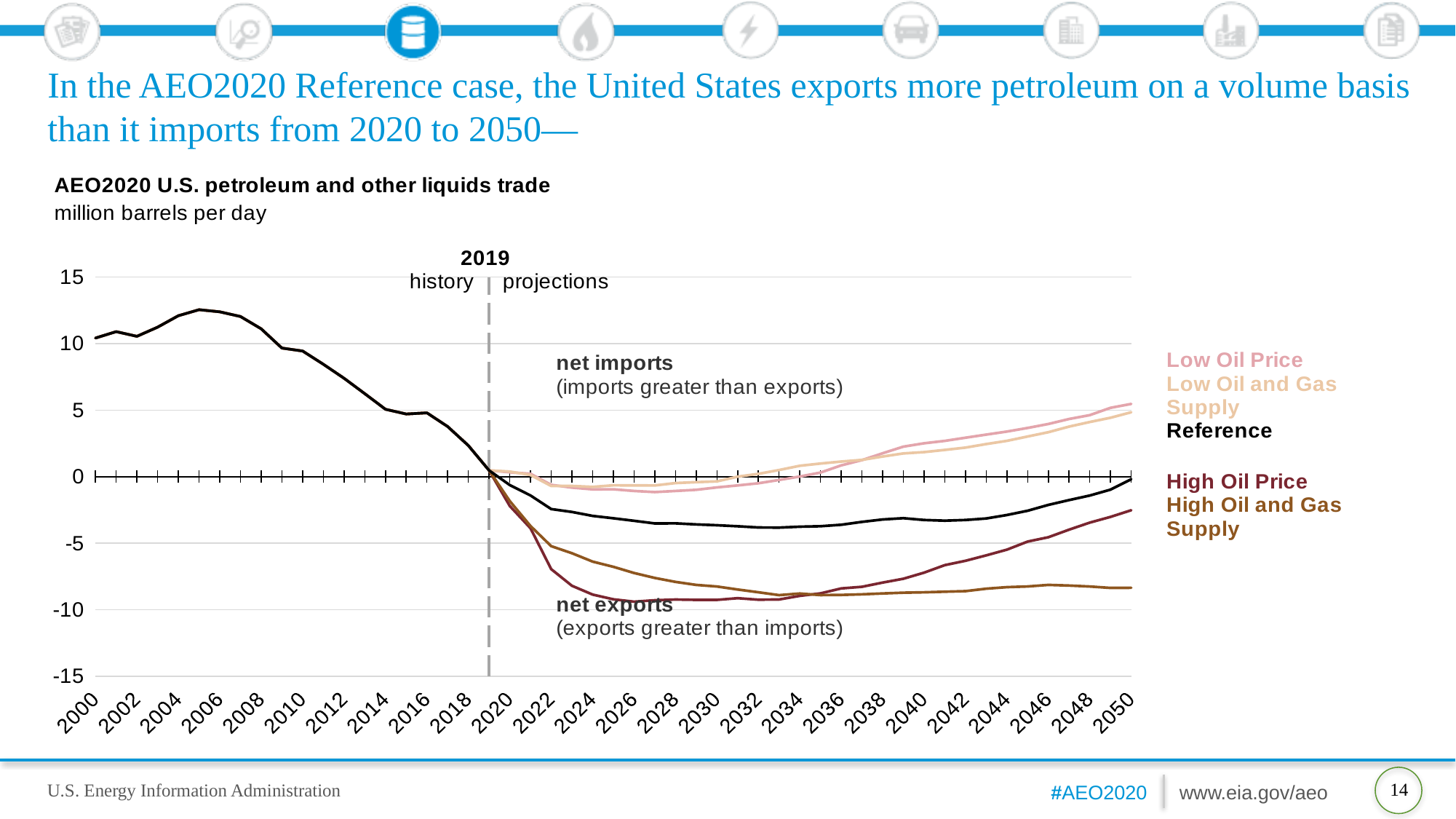
Is the High Oil and Gas Supply value in 2040 greater or less than -5? less Is the Reference case value in 2030 greater or less than 0? less Which year marks the boundary between history and projections? 2019 Which series has the lowest value in 2045? High Oil and Gas Supply Is the historical value in 2005 greater or less than 10? greater What kind of chart is shown on the slide? line chart Does the Reference case line rise or fall from 2035 to 2050? rise In 2050, which is higher: the Low Oil Price series or the High Oil Price series? Low Oil Price What unit is the chart measured in? million barrels per day How many scenario series does the legend list? 5